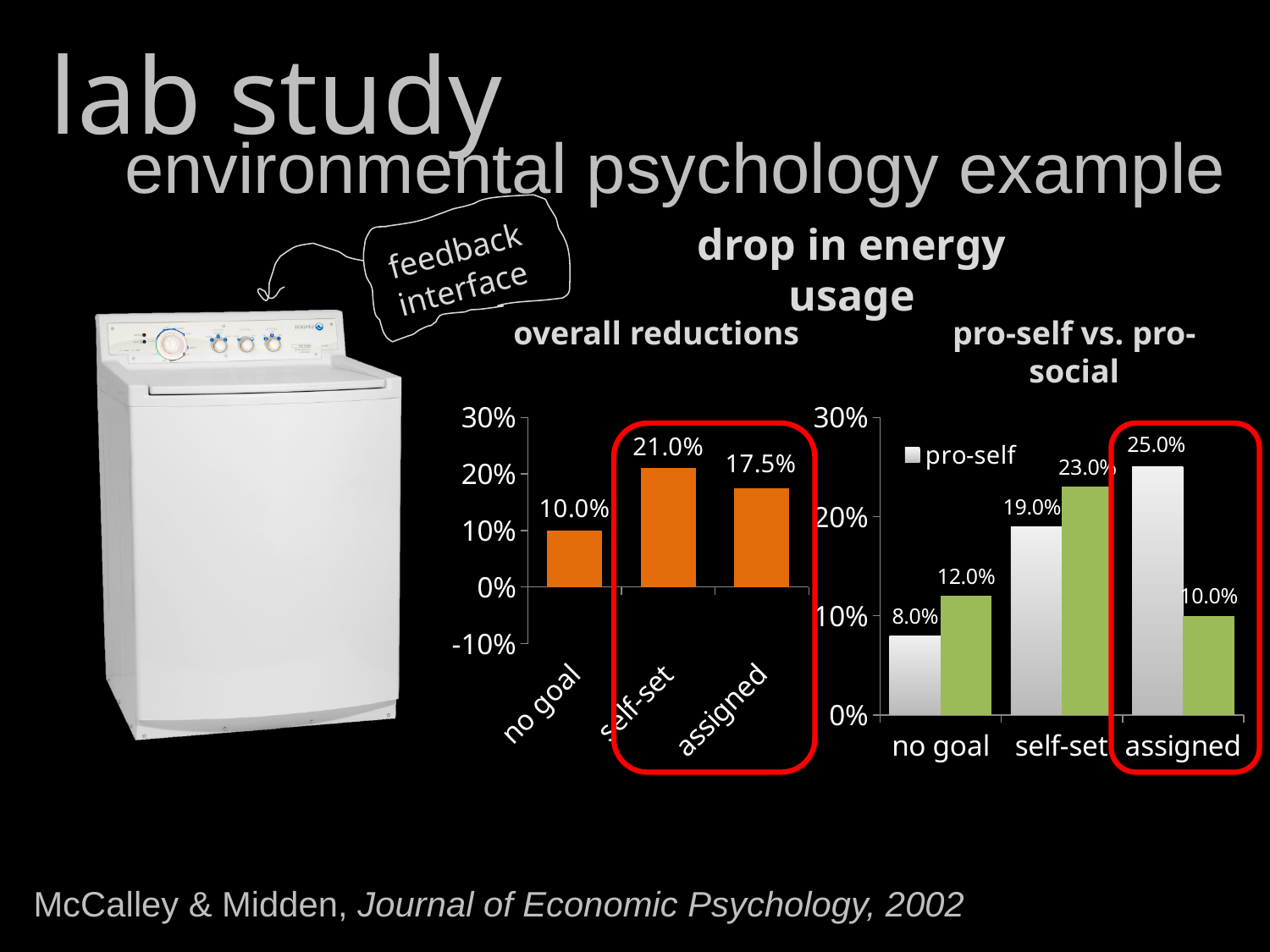
In the 'overall reductions' chart, what is the value for 'self-set'? 21.0% In the 'overall reductions' chart, which category has the highest value? self-set In the 'overall reductions' chart, which category has the lowest value? no goal In the 'overall reductions' chart, what is the value for 'assigned'? 17.5% In the 'pro-self vs. pro-social' chart, what is the pro-social value for 'self-set'? 23.0% In the 'pro-self vs. pro-social' chart, which is larger for 'no goal': the pro-self value or the pro-social value? pro-social In the 'pro-self vs. pro-social' chart, what is the pro-self value for 'assigned'? 25.0% In the 'pro-self vs. pro-social' chart, what is the difference between the pro-self and pro-social values for 'assigned'? 15.0% What kind of chart is the 'overall reductions' chart? bar chart In the 'overall reductions' chart, how many categories are shown? 3 In the 'overall reductions' chart, what is the difference between the 'self-set' and 'no goal' values? 11.0% In the 'pro-self vs. pro-social' chart, which category has the highest pro-self value? assigned